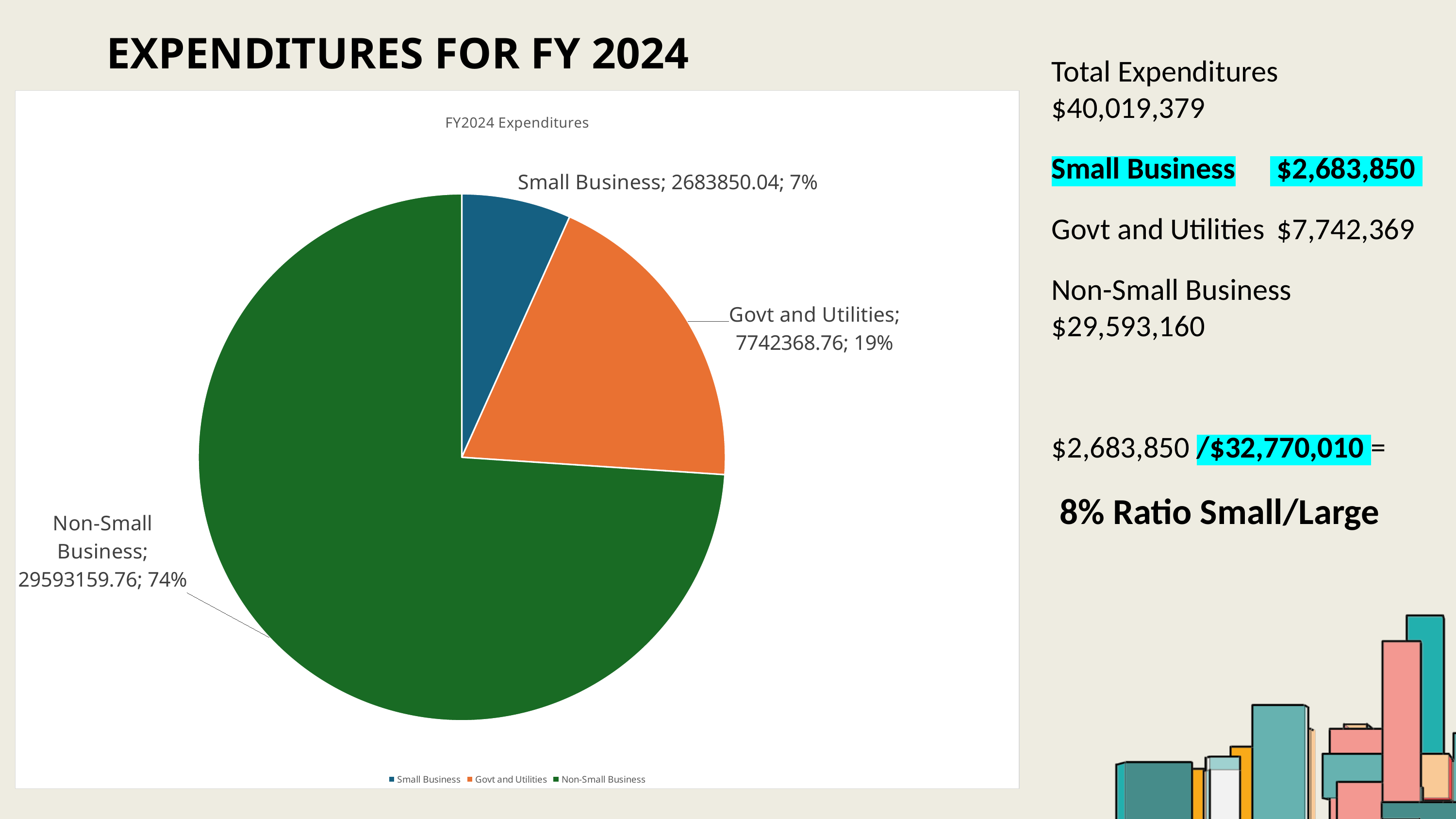
Which category has the smallest slice of the pie? Small Business Which category has the largest slice of the pie? Non-Small Business How many entries does the chart legend list? 3 How many slices does the pie chart have? 3 Which is larger, Govt and Utilities or Small Business? Govt and Utilities What value is shown for Small Business in the chart? 2683850.04 What value is shown for Non-Small Business in the chart? 29593159.76 What share of the pie does Non-Small Business represent? 74% What type of chart is shown on the slide? pie chart What is the title of the chart? FY2024 Expenditures What share of the pie does Small Business represent? 7% What value is shown for Govt and Utilities in the chart? 7742368.76